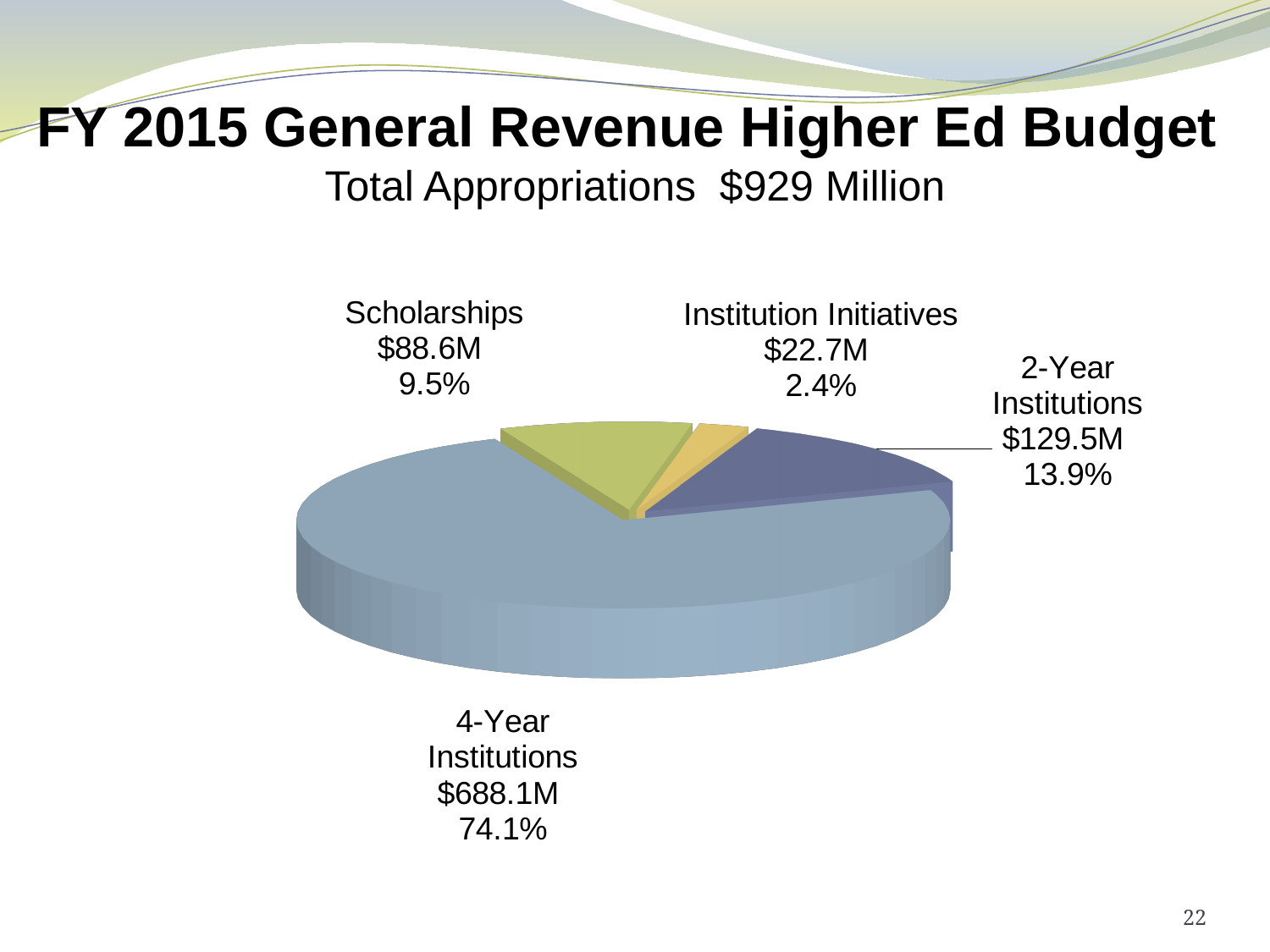
What total appropriations amount is stated in the chart's subtitle? $929 Million Which is larger, the amount for Scholarships or the amount for 2-Year Institutions? 2-Year Institutions How many slices does the pie chart have? 4 What is the difference in dollars between 2-Year Institutions and Scholarships? $40.9M Which category has the largest slice of the pie? 4-Year Institutions What share of the pie do 4-Year Institutions represent? 74.1% Which category has the smallest slice of the pie? Institution Initiatives What kind of chart is shown on the slide? pie chart What is the dollar amount for Scholarships? $88.6M What share of the pie do 2-Year Institutions represent? 13.9% What is the dollar amount for 4-Year Institutions? $688.1M What is the dollar amount for Institution Initiatives? $22.7M